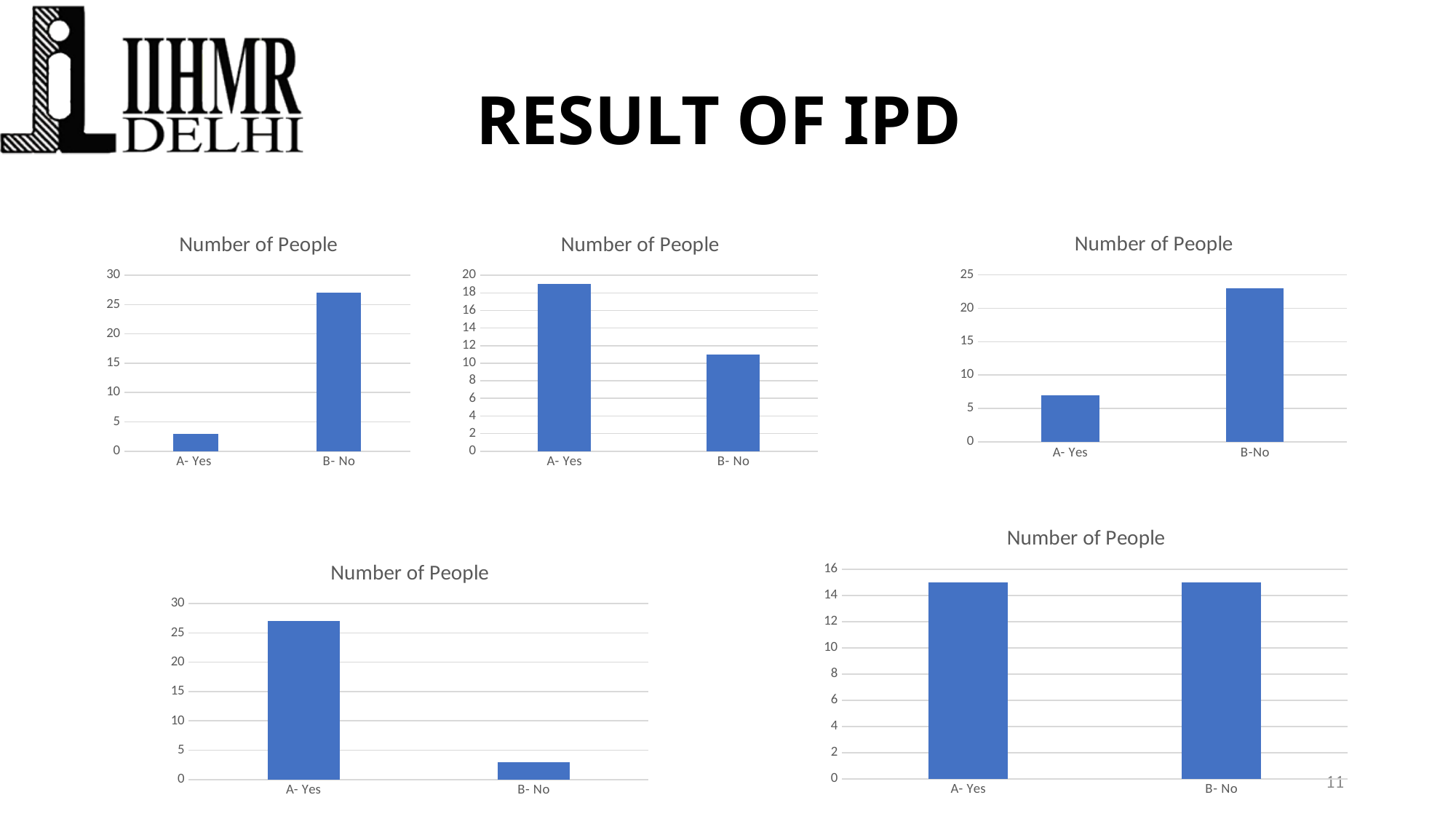
In the top-right chart, which category has the lowest value? A- Yes In the top-middle chart, is the value for B- No greater or less than 10? greater In the bottom-right chart, is the value for A- Yes greater or less than 14? greater In the top-middle chart, is the value for A- Yes greater or less than 18? greater In the bottom-left chart, which category has the higher value, A- Yes or B- No? A- Yes In the top-left chart, which category has the higher value, A- Yes or B- No? B- No How many charts are on the slide? 5 In the top-middle chart, which category has the highest value? A- Yes